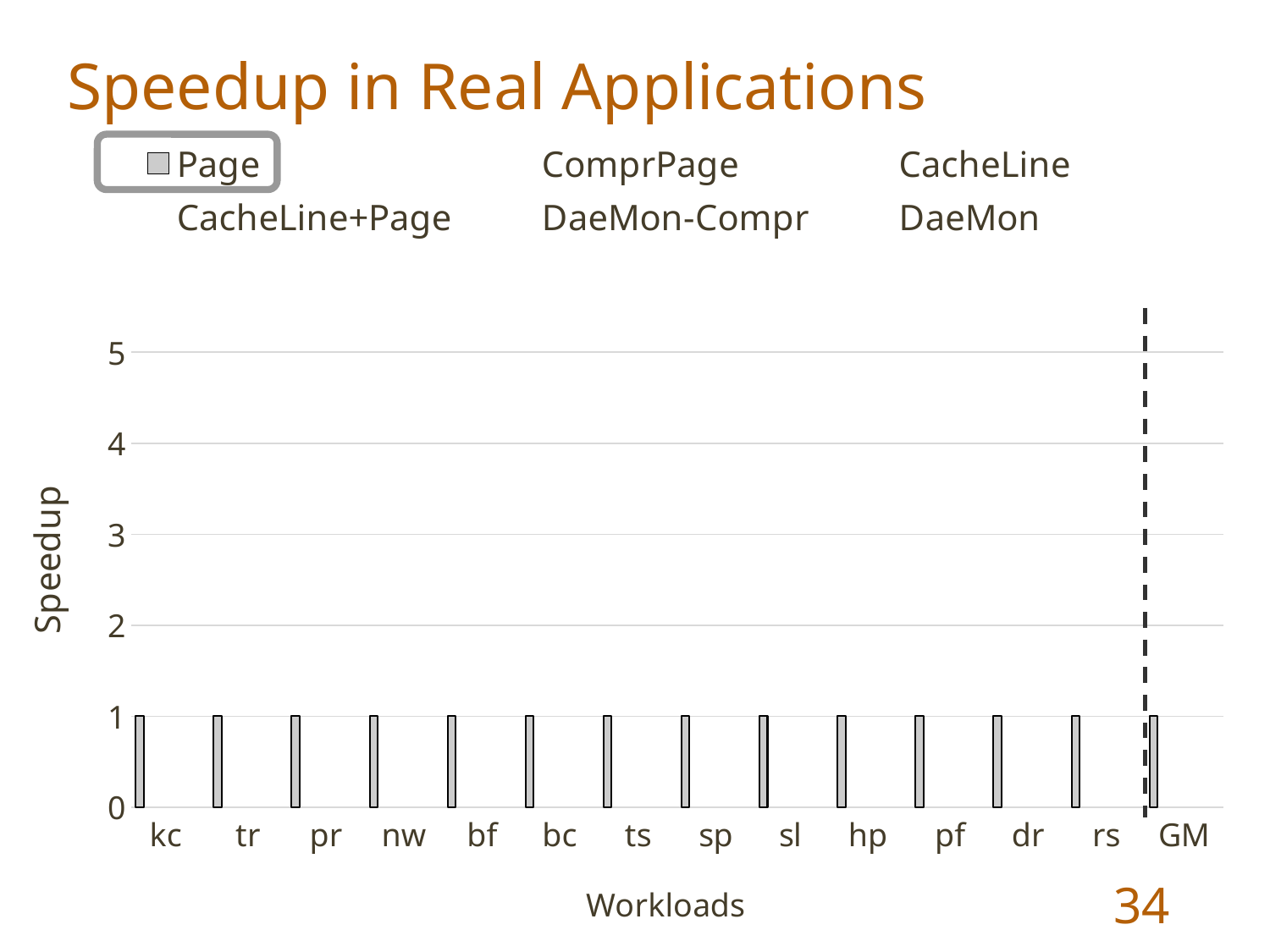
Is the Page value for hp greater or less than 2? less How many series does the legend list? 6 What is the Page speedup value for GM? 1 Is the Page value for dr greater or less than 3? less What is the Page speedup value for kc? 1 What is the difference between the Page values for tr and rs? 0 What is the title of the chart? Speedup in Real Applications What kind of chart is shown on the slide? bar chart What is the label of the y axis? Speedup How many workload categories are shown on the x axis? 14 What is the Page speedup value for sp? 1 Do the Page values rise, fall, or stay flat across the workloads on the x axis? stay flat